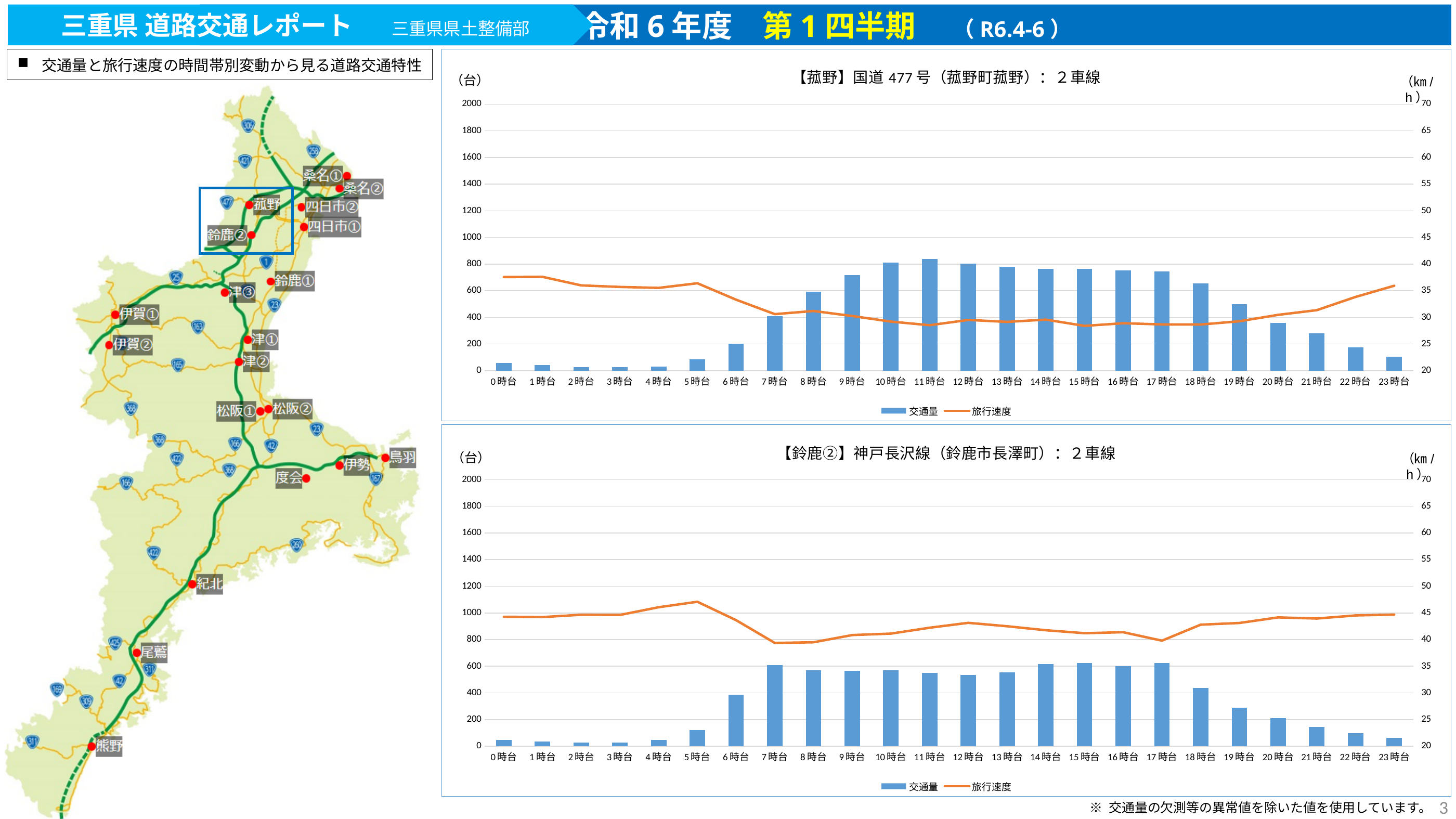
In the top chart (【菰野】国道477号), is the 旅行速度 value for 0時台 greater or less than 35 km/h? greater In the top chart (【菰野】国道477号), which has the larger 交通量 value, 8時台 or 9時台? 9時台 In the bottom chart (【鈴鹿②】神戸長沢線), is the 交通量 value for 19時台 greater or less than 400? less How many series does the legend of the top chart (【菰野】国道477号) list? 2 In the bottom chart (【鈴鹿②】神戸長沢線), which has the larger 交通量 value, 6時台 or 7時台? 7時台 In the top chart (【菰野】国道477号), do the 交通量 bars rise or fall from 17時台 to 23時台? fall In the bottom chart (【鈴鹿②】神戸長沢線), is the 旅行速度 value for 5時台 greater or less than 45 km/h? greater What kind of chart is the top chart (【菰野】国道477号)? Combined bar and line chart How many time-of-day categories are shown on the x axis of the bottom chart (【鈴鹿②】神戸長沢線)? 24